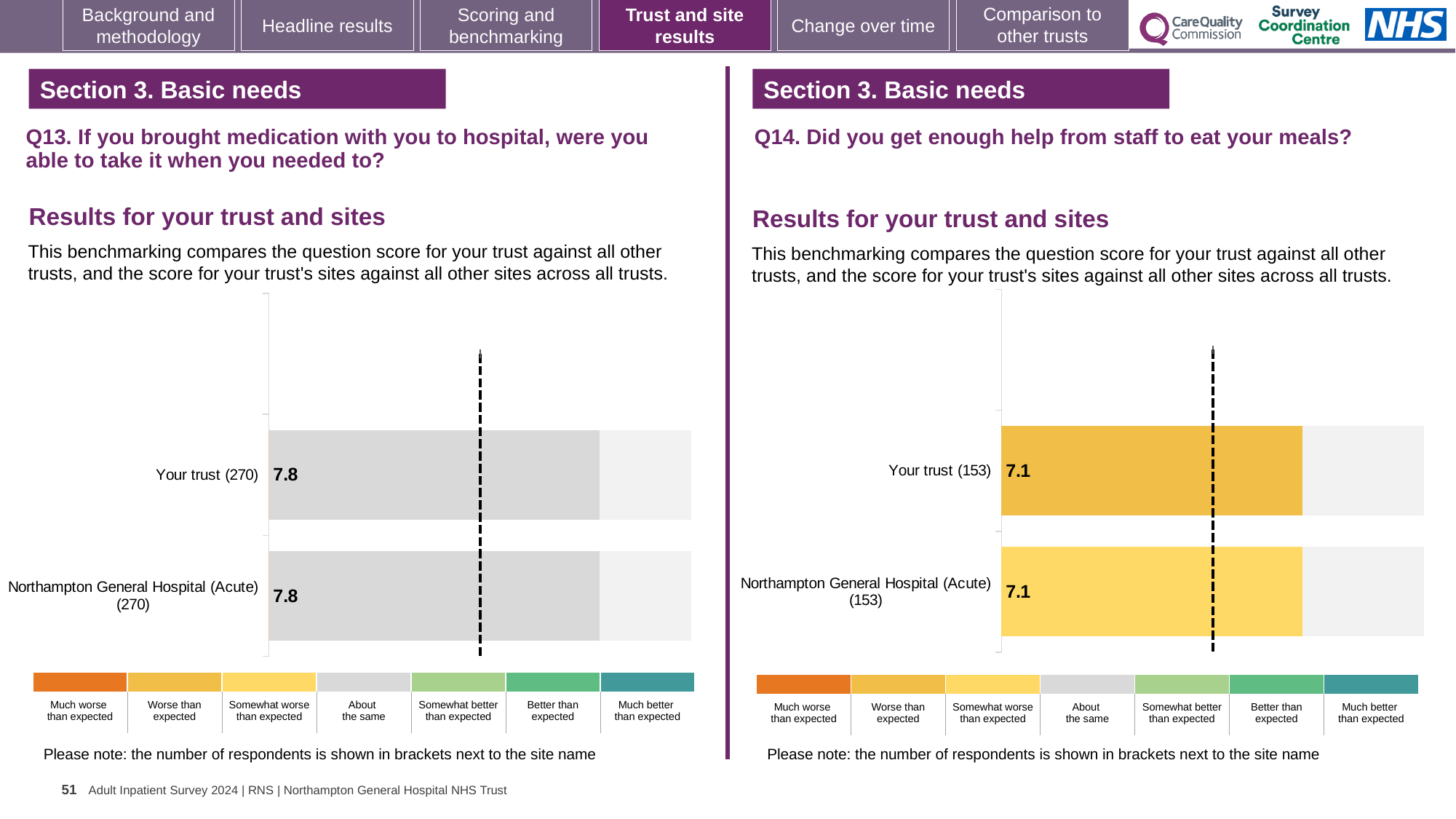
On the Q13 chart (left), how many respondents are shown in brackets for Your trust? 270 How many bars are plotted on the Q14 chart (right)? 2 On the Q14 chart (right), what is the score for Northampton General Hospital (Acute)? 7.1 On the Q13 chart (left), what is the score for Your trust? 7.8 On the Q13 chart (left), what is the score for Northampton General Hospital (Acute)? 7.8 On the Q14 chart (right), which benchmark category does the colour of the Your trust bar correspond to in the key? Worse than expected On the Q14 chart (right), what is the difference between the score for Your trust and the score for Northampton General Hospital (Acute)? 0.0 On the Q14 chart (right), what is the score for Your trust? 7.1 On the Q14 chart (right), how many respondents are shown in brackets for Northampton General Hospital (Acute)? 153 On the Q13 chart (left), what is the difference between the score for Your trust and the score for Northampton General Hospital (Acute)? 0.0 How many bars are plotted on the Q13 chart (left)? 2 What kind of chart is the Q13 chart (left)? Bar chart